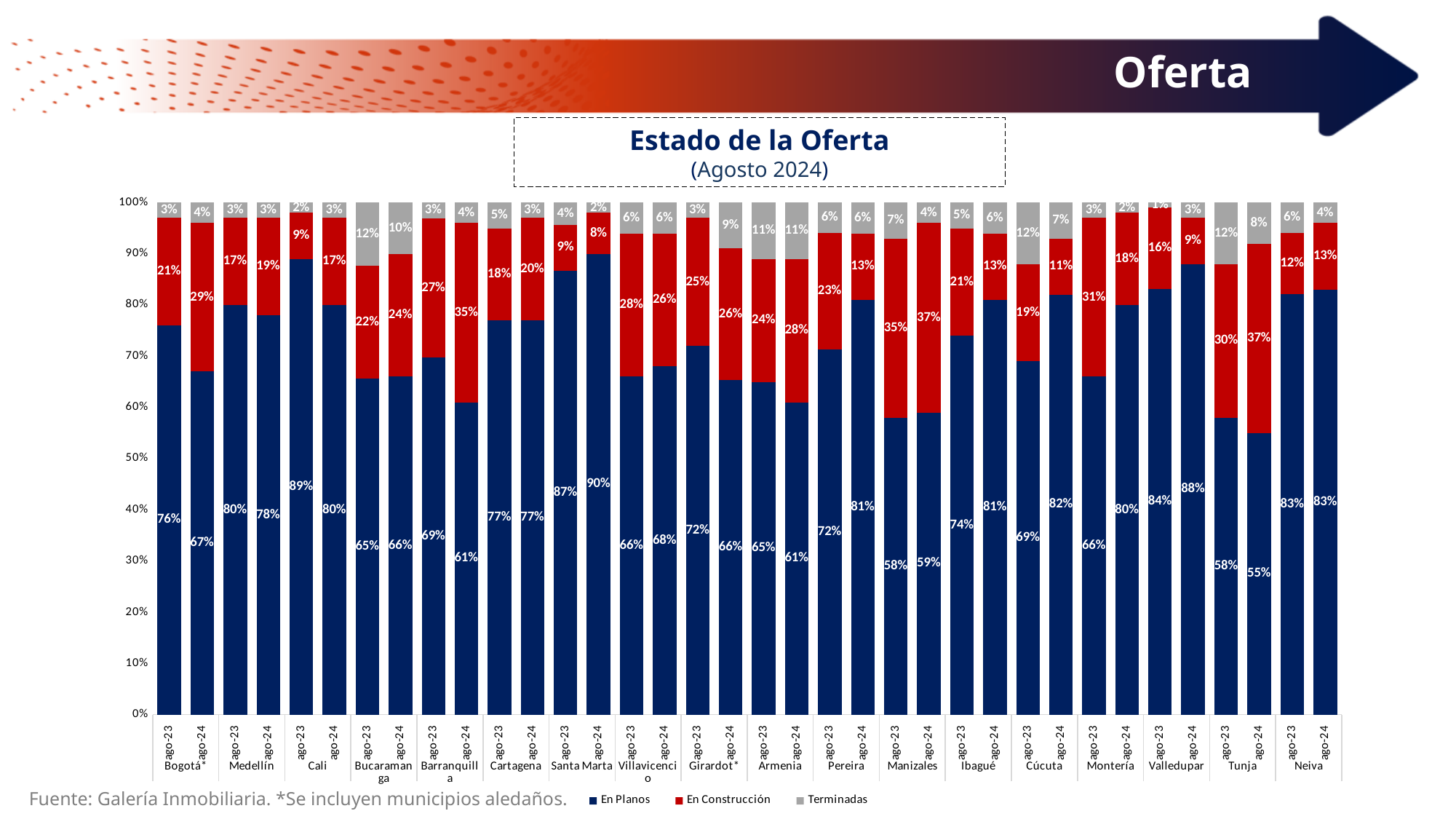
Did the En Planos share for Montería rise or fall from ago-23 to ago-24? Rise (66% to 80%) Which is larger: the En Construcción share for Manizales in ago-24 or for Pereira in ago-24? Manizales ago-24 (37%) What type of chart is shown on the slide? Stacked bar chart What is the Terminadas share for Cúcuta in ago-23? 12% What is the title of the chart? Estado de la Oferta (Agosto 2024) How many series does the legend list? 3 What is the En Construcción share for Barranquilla in ago-24? 35% How many cities are shown on the x axis? 18 Which city and period has the highest En Planos share? Santa Marta, ago-24 (90%) What is the difference between the En Planos share for Cali in ago-23 and in ago-24? 9 percentage points What is the En Planos share for Bogotá* in ago-24? 67% Which city and period has the lowest En Planos share? Tunja, ago-24 (55%)